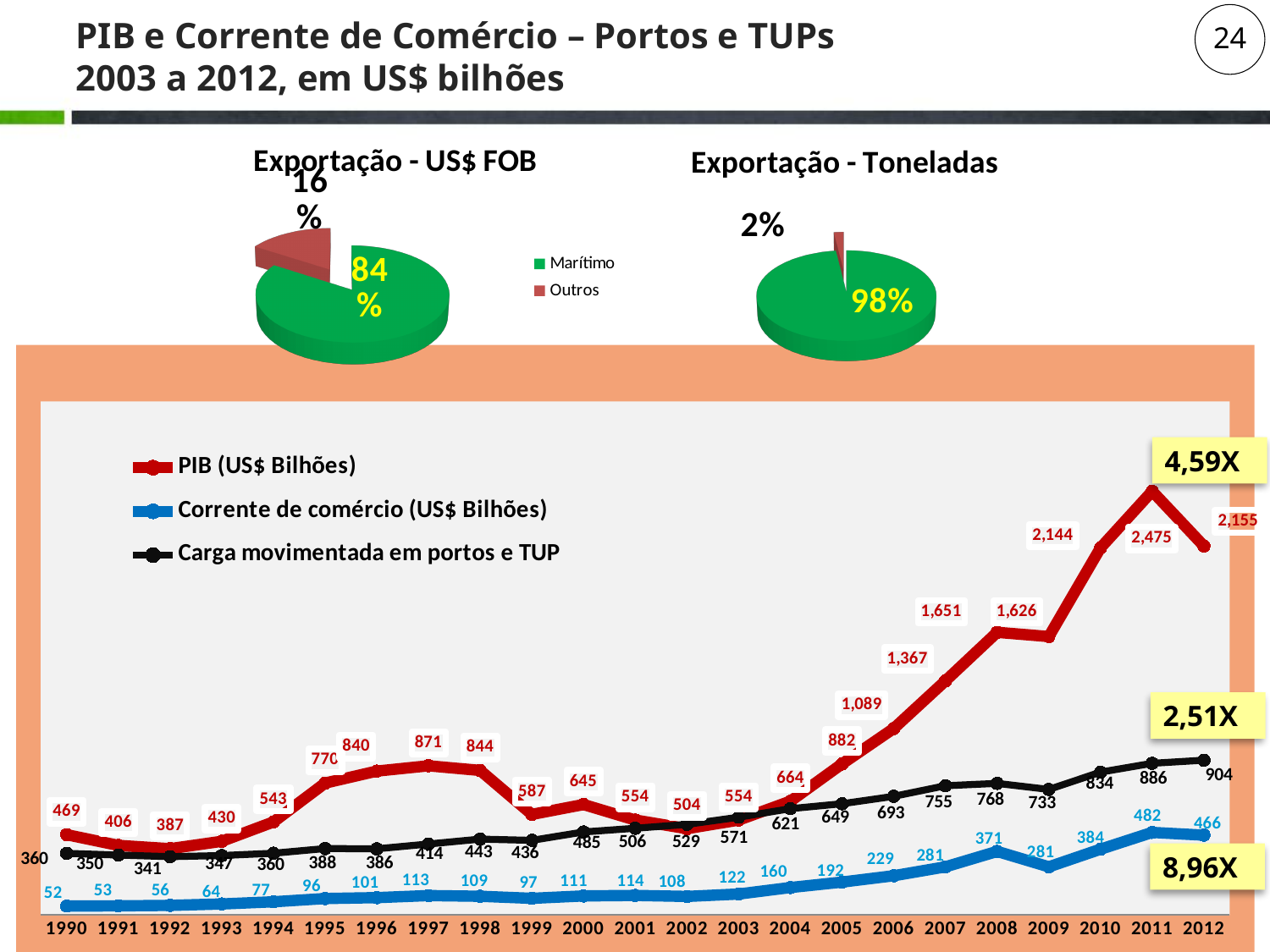
How many series does the legend of the line chart list? 3 In the line chart, what is the value of PIB (US$ Bilhões) in 2011? 2,475 In the line chart, what is the value of Corrente de comércio (US$ Bilhões) in 2012? 466 In the line chart, what is the difference between the PIB (US$ Bilhões) values for 2012 and 2011? 320 In the line chart, which is larger: Carga movimentada em portos e TUP in 2009 or in 2010? 2010 In the line chart, what is the value of Carga movimentada em portos e TUP in 2008? 768 In the pie chart titled 'Exportação - US$ FOB', what share does Outros have? 16% How many years are shown on the x axis of the line chart? 23 In the pie chart titled 'Exportação - Toneladas', what share does Marítimo have? 98% In the line chart, in which year is Corrente de comércio (US$ Bilhões) at its lowest? 1990 In the line chart, does Carga movimentada em portos e TUP generally rise or fall from 1990 to 2012? rise In the line chart, in which year does PIB (US$ Bilhões) reach its highest value? 2011